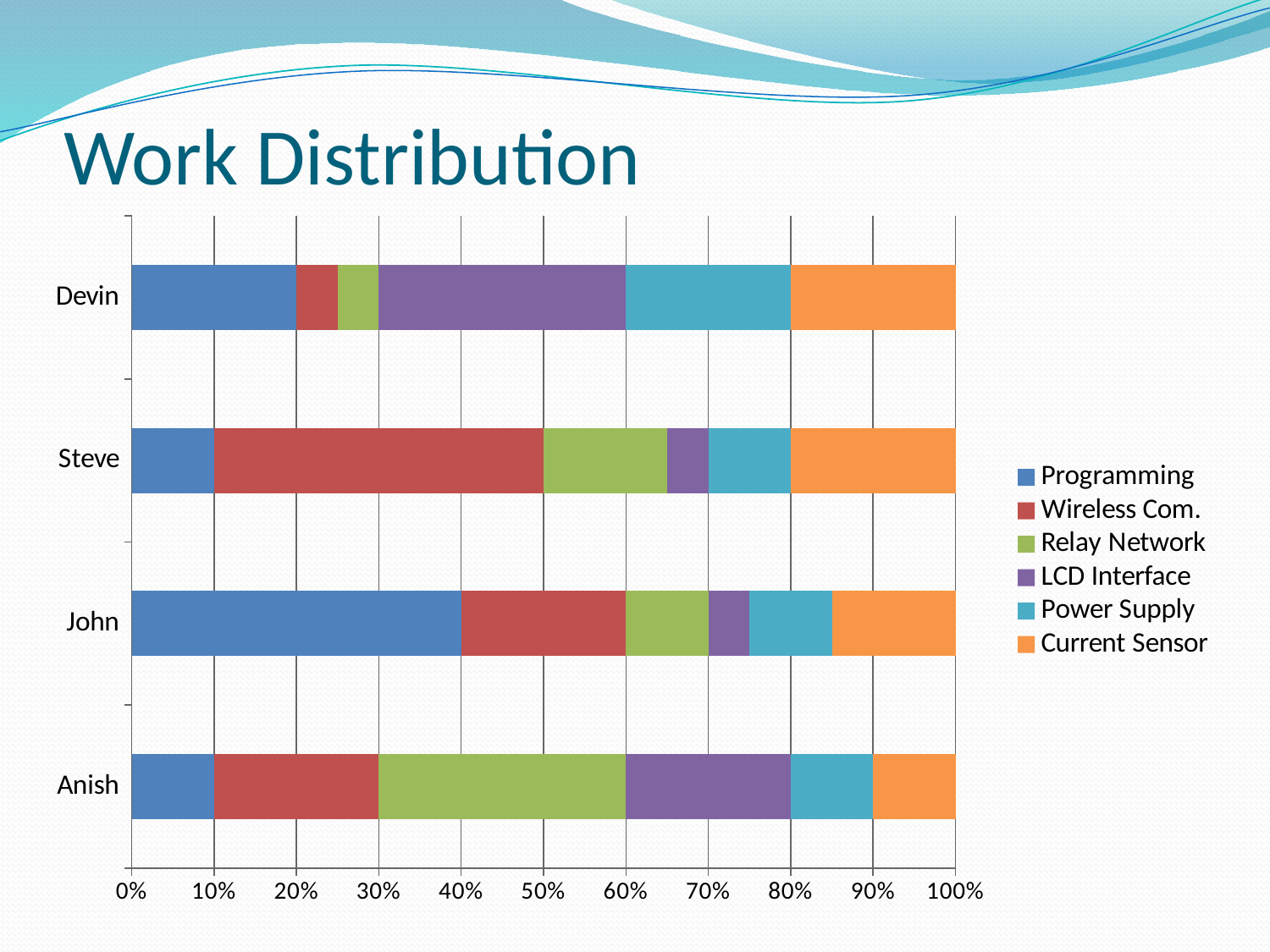
How many series does the legend list? 6 How many people (categories) are shown on the chart? 4 Which person has the largest Relay Network segment? Anish Which colour represents Programming in the legend? Blue Which person has the largest LCD Interface segment? Devin What is the total of each stacked bar on the chart? 100% Is the Wireless Com. segment larger for Steve or for Devin? Steve Is the Programming share for John greater or less than 30%? greater Is the Current Sensor segment larger for Devin or for Anish? Devin What kind of chart is shown on the slide? Stacked bar chart What is the title of the chart? Work Distribution Which person has the largest Programming segment? John